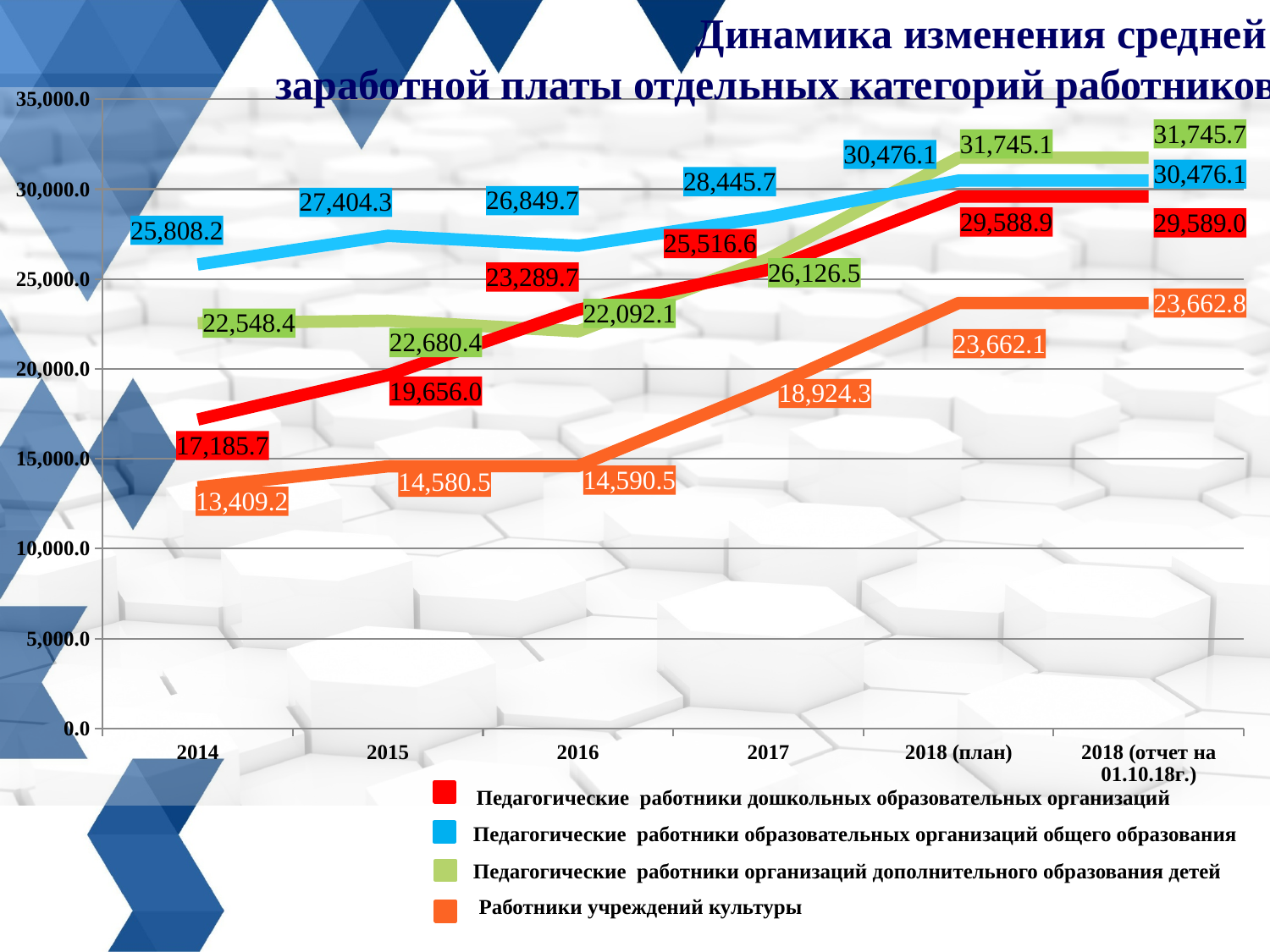
Which is larger in 2016: the value for Педагогические работники дошкольных образовательных организаций or for Педагогические работники организаций дополнительного образования детей? Педагогические работники дошкольных образовательных организаций What is the value for Педагогические работники организаций дополнительного образования детей in 2018 (план)? 31,745.1 How many points along the x axis does the chart have? 6 What is the difference between the 2018 (план) and 2014 values for Работники учреждений культуры? 10,252.9 What is the value for Работники учреждений культуры in 2017? 18,924.3 What is the value for Педагогические работники дошкольных образовательных организаций in 2015? 19,656.0 Which series has the lowest value in 2014? Работники учреждений культуры How many series does the legend list? 4 Which series has the highest value in 2018 (отчет на 01.10.18г.)? Педагогические работники организаций дополнительного образования детей Does the value for Работники учреждений культуры rise or fall from 2014 to 2018 (план)? rise What kind of chart is shown on the slide? line chart What is the value for Педагогические работники образовательных организаций общего образования in 2014? 25,808.2